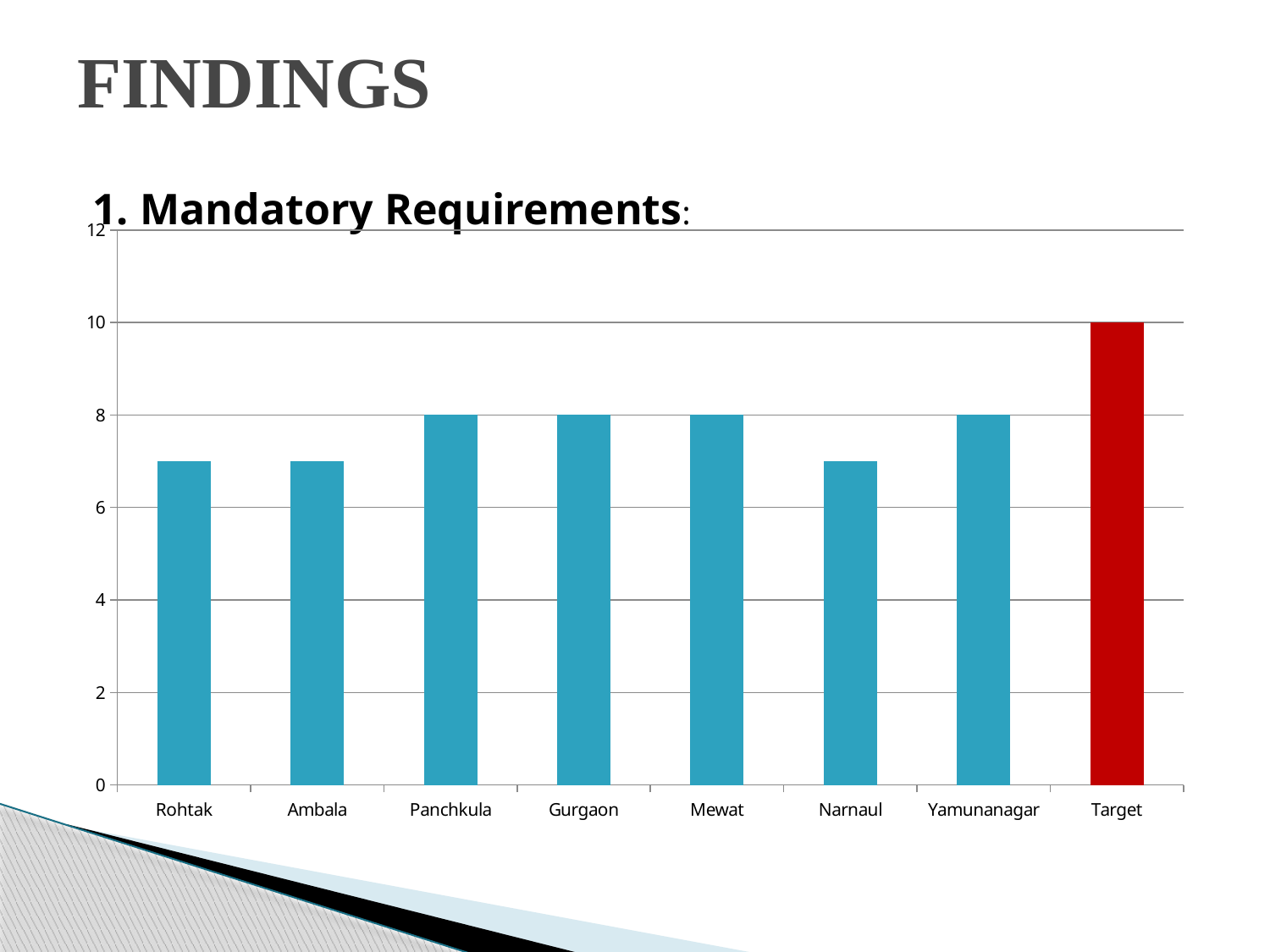
Is the value for Rohtak greater or less than 6? greater What type of chart is shown on the slide? bar chart What is the value for Yamunanagar? 8 Is the value for Narnaul greater or less than 8? less What is the value for Target? 10 What is the heading shown above the chart? 1. Mandatory Requirements How many categories are shown on the x axis of the chart? 8 What colour is the Target bar? red Which category has the highest value? Target What is the value for Panchkula? 8 Which is larger, the value for Target or the value for Mewat? Target What is the difference between the value for Target and the value for Gurgaon? 2